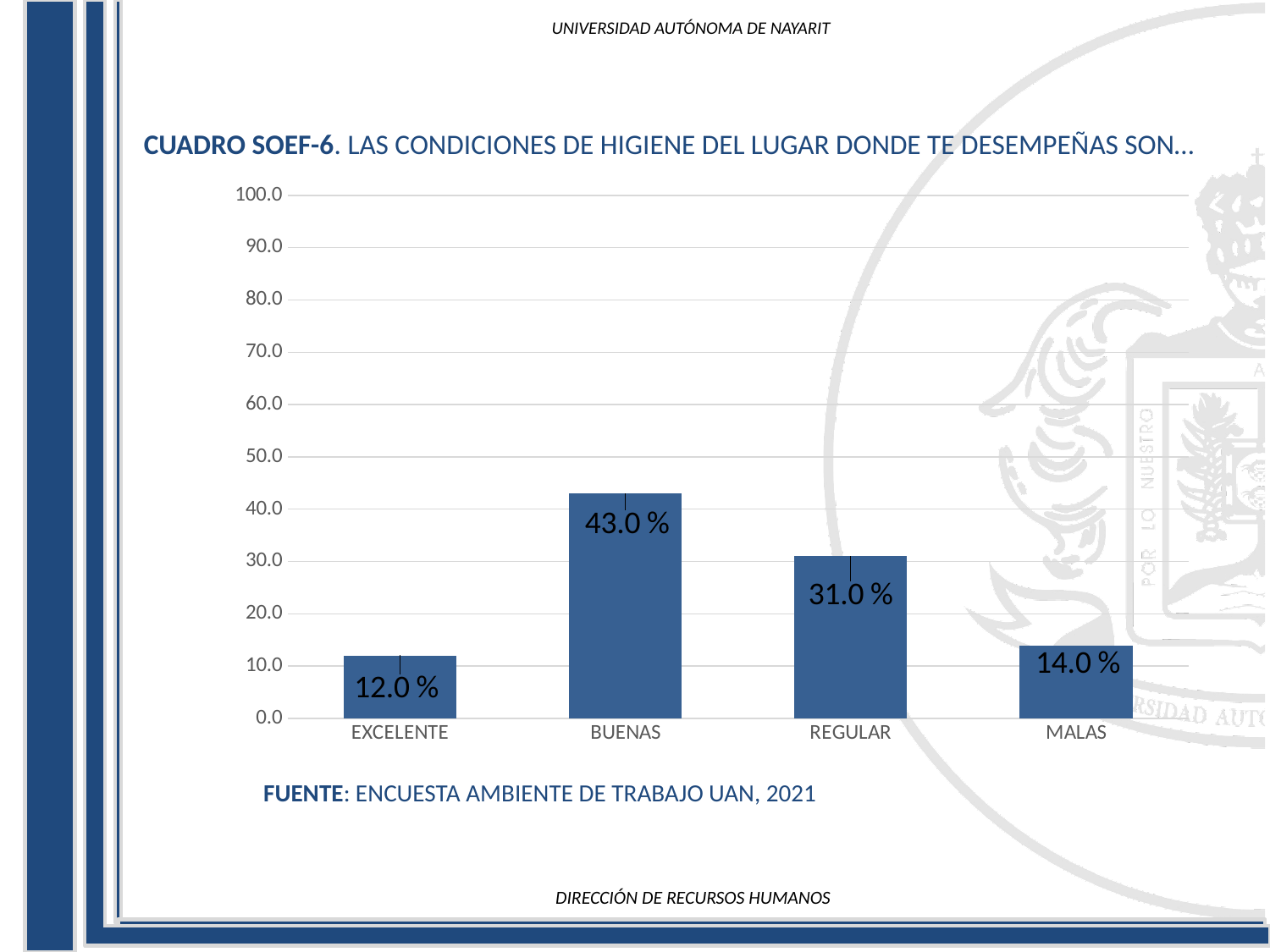
Which is larger, the value for MALAS or the value for EXCELENTE? MALAS What kind of chart is shown on the slide? bar chart What source is cited below the chart? ENCUESTA AMBIENTE DE TRABAJO UAN, 2021 Which category has the highest value? BUENAS What is the value for MALAS? 14.0 % What is the value for EXCELENTE? 12.0 % Is the value for REGULAR greater or less than 40.0? less What is the difference between the values for BUENAS and REGULAR? 12.0 % What is the value for BUENAS? 43.0 % Which category has the lowest value? EXCELENTE How many categories are shown on the x axis? 4 What is the value for REGULAR? 31.0 %